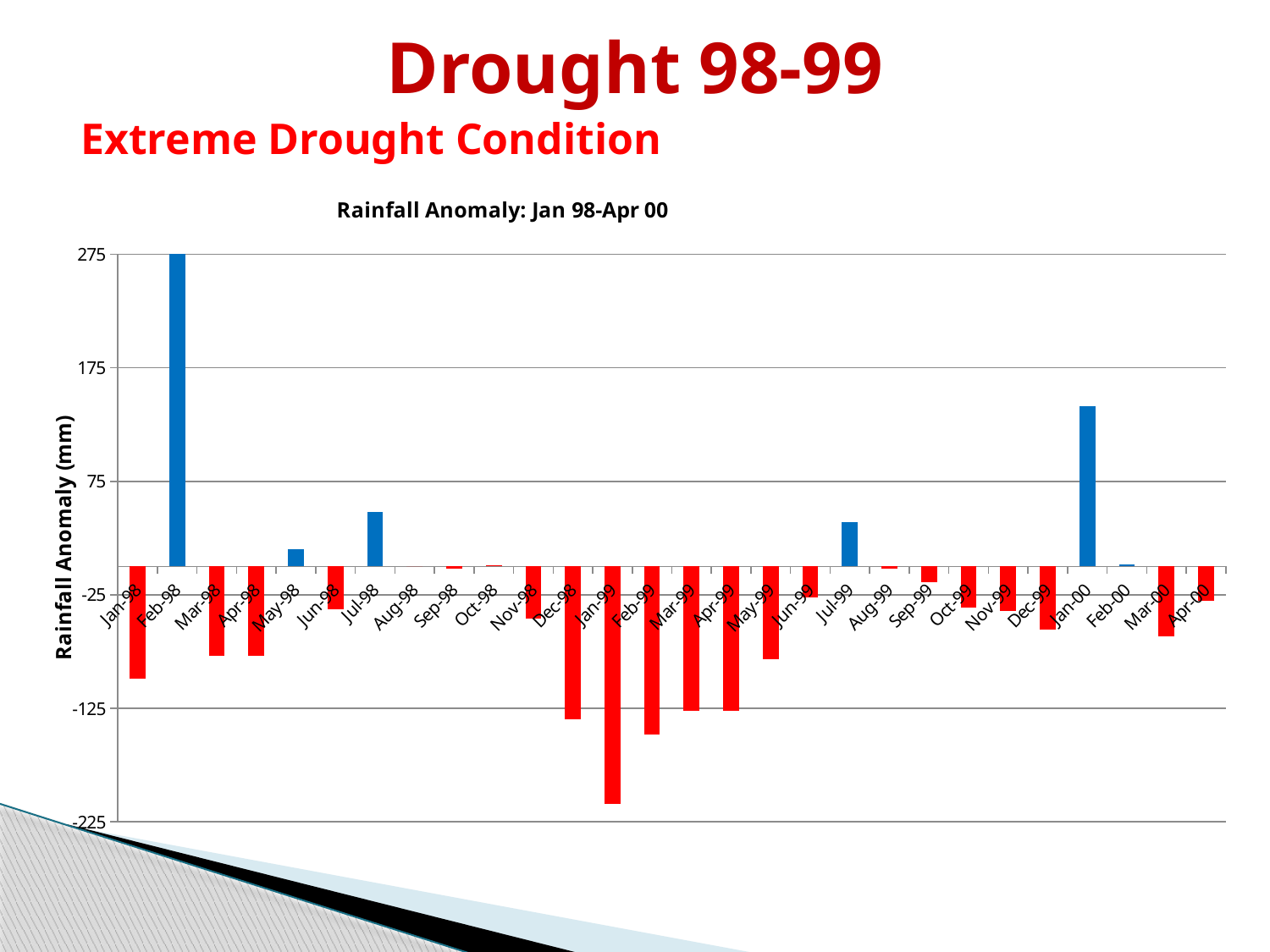
How many months (categories) are plotted on the x axis? 28 What is the title of the chart? Rainfall Anomaly: Jan 98-Apr 00 What kind of chart is shown on the slide? bar chart Is the value for Jan-99 greater or less than -125? less Which has the larger rainfall anomaly, Feb-98 or Jan-00? Feb-98 Which has the lower rainfall anomaly, Dec-98 or Jan-99? Jan-99 Which month has the lowest rainfall anomaly? Jan-99 Is the value for Jan-00 greater or less than 75? greater What is the label of the vertical axis? Rainfall Anomaly (mm) Is the value for Jul-98 greater or less than 75? less Which month has the highest rainfall anomaly? Feb-98